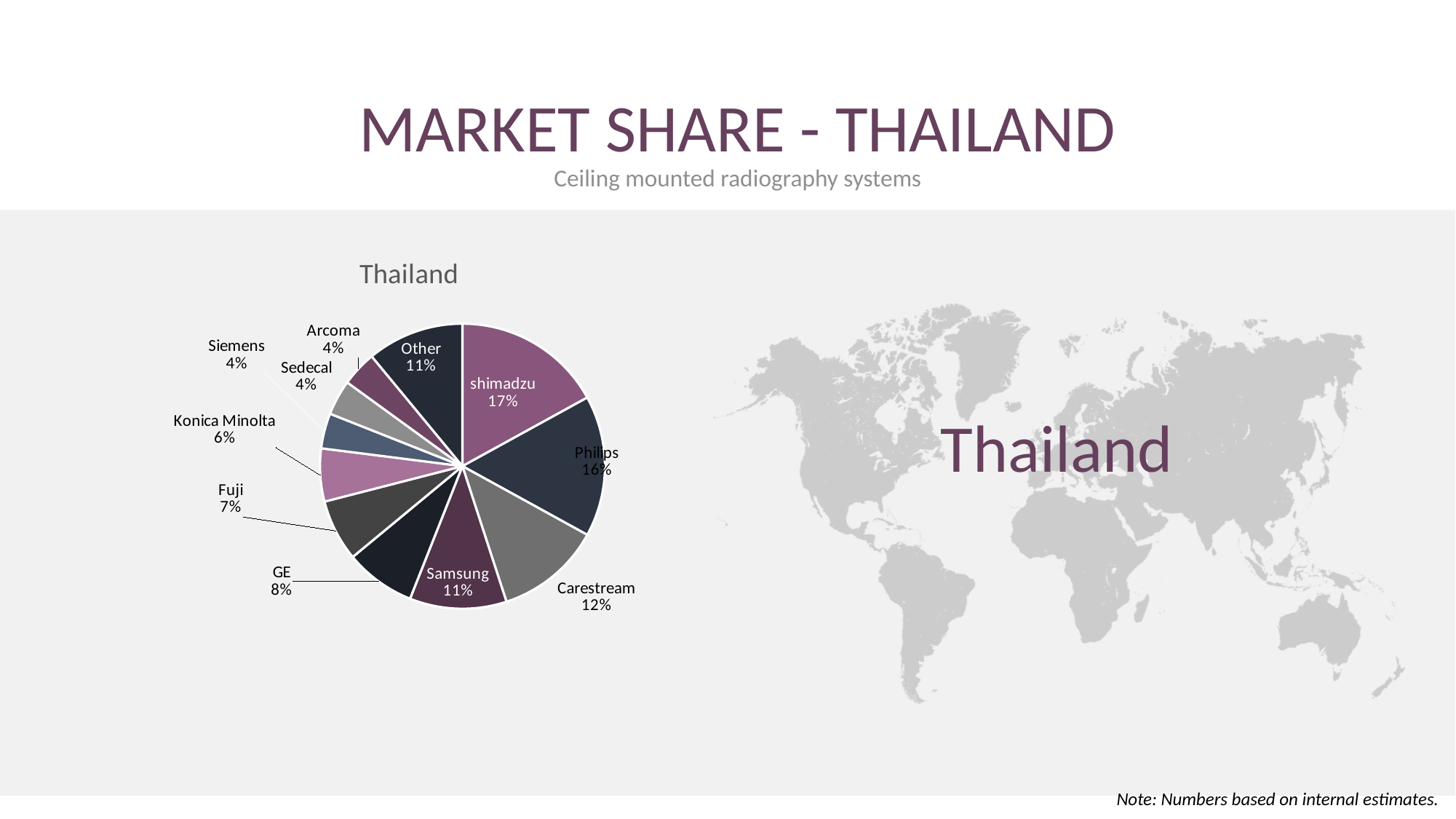
What is the market share of shimadzu in the Thailand pie chart? 17% Which company has the largest slice in the Thailand pie chart? shimadzu What is the combined market share of Sedecal, Siemens and Arcoma? 12% What is the difference in market share between GE and Fuji? 1% What is the difference in market share between shimadzu and Philips? 1% What is the title of the pie chart? Thailand What is the market share of Konica Minolta in the Thailand pie chart? 6% How many slices does the Thailand pie chart have? 11 What is the market share of Philips in the Thailand pie chart? 16% What is the market share of Carestream in the Thailand pie chart? 12% What kind of chart is shown on the slide? pie chart Which has a larger market share, Samsung or Carestream? Carestream